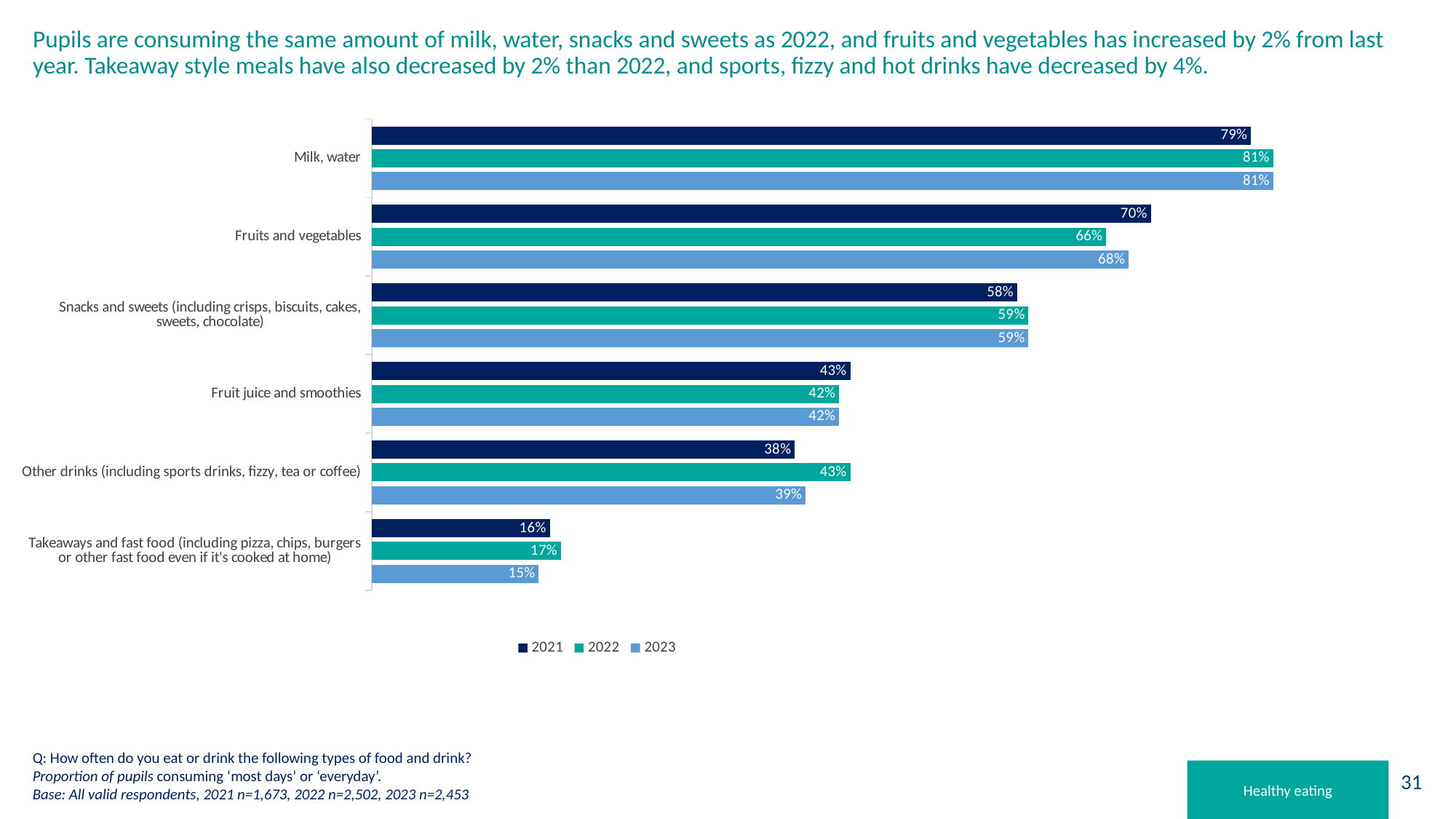
What kind of chart is shown on the slide? Bar chart How many series does the legend list? 3 Which category has the highest 2023 value? Milk, water Which is larger for Fruit juice and smoothies: the 2021 value or the 2023 value? 2021 What is the difference between the 2022 and 2023 values for Other drinks (including sports drinks, fizzy, tea or coffee)? 4% How many categories are shown on the chart? 6 What is the 2023 value for Milk, water? 81% Which category has the lowest 2021 value? Takeaways and fast food (including pizza, chips, burgers or other fast food even if it's cooked at home) What is the difference between the 2021 and 2022 values for Fruits and vegetables? 4% What is the 2021 value for Fruits and vegetables? 70% What is the 2023 value for Takeaways and fast food? 15% What is the 2022 value for Other drinks (including sports drinks, fizzy, tea or coffee)? 43%